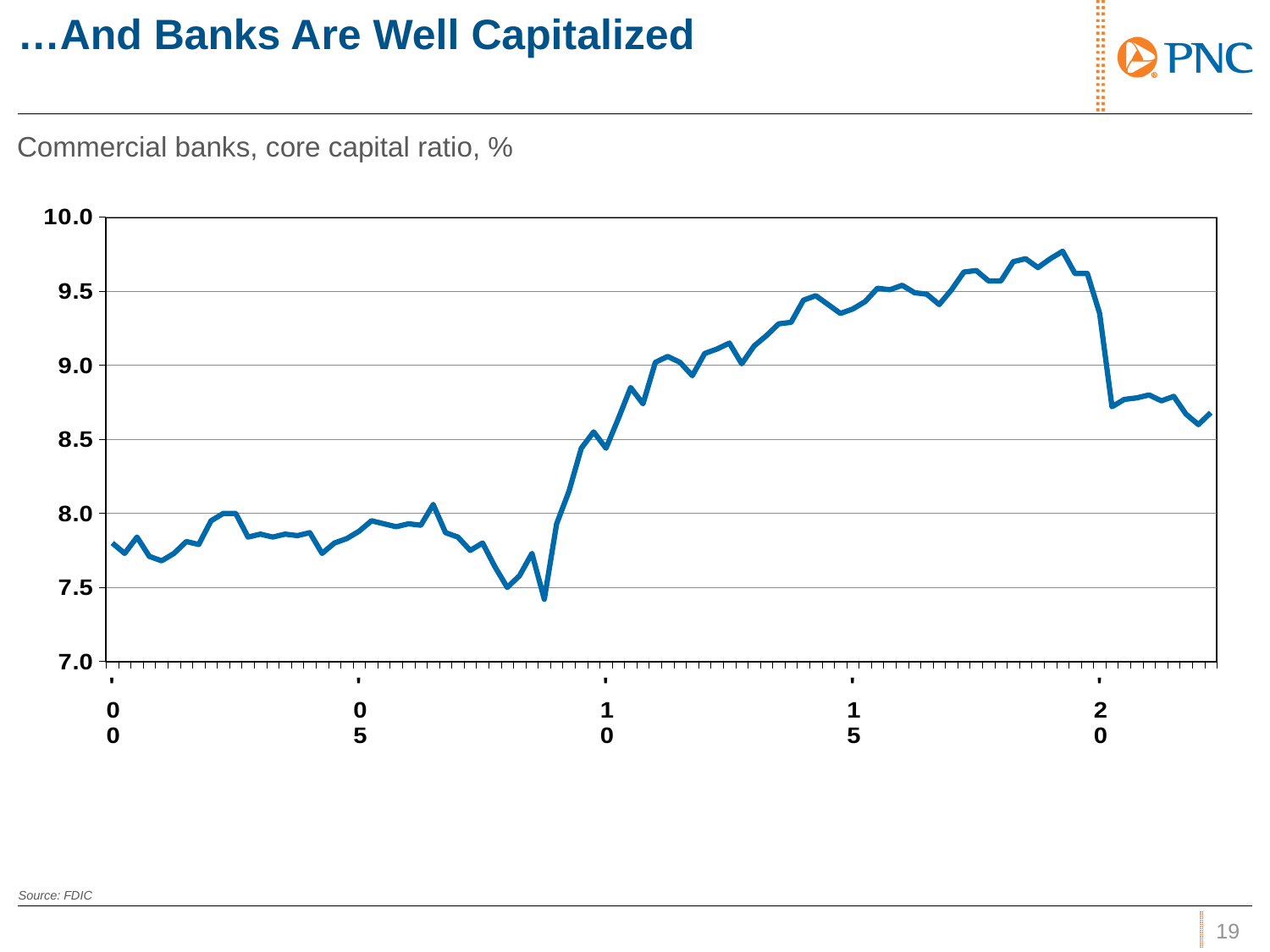
Which is larger, the value at the 05 tick or the value at the 15 tick? 15 What kind of chart is shown on the slide? line chart What is the subtitle describing the data plotted in the chart? Commercial banks, core capital ratio, % Is the lowest point of the line greater or less than 7.5? less Is the value at the 15 tick greater or less than 9.0? greater Is the value at the start of the line (year 00) greater or less than 7.5? greater How many year labels are shown on the x axis? 5 Does the core capital ratio rise or fall between the 10 tick and the 15 tick? rise What source is cited for the chart? FDIC